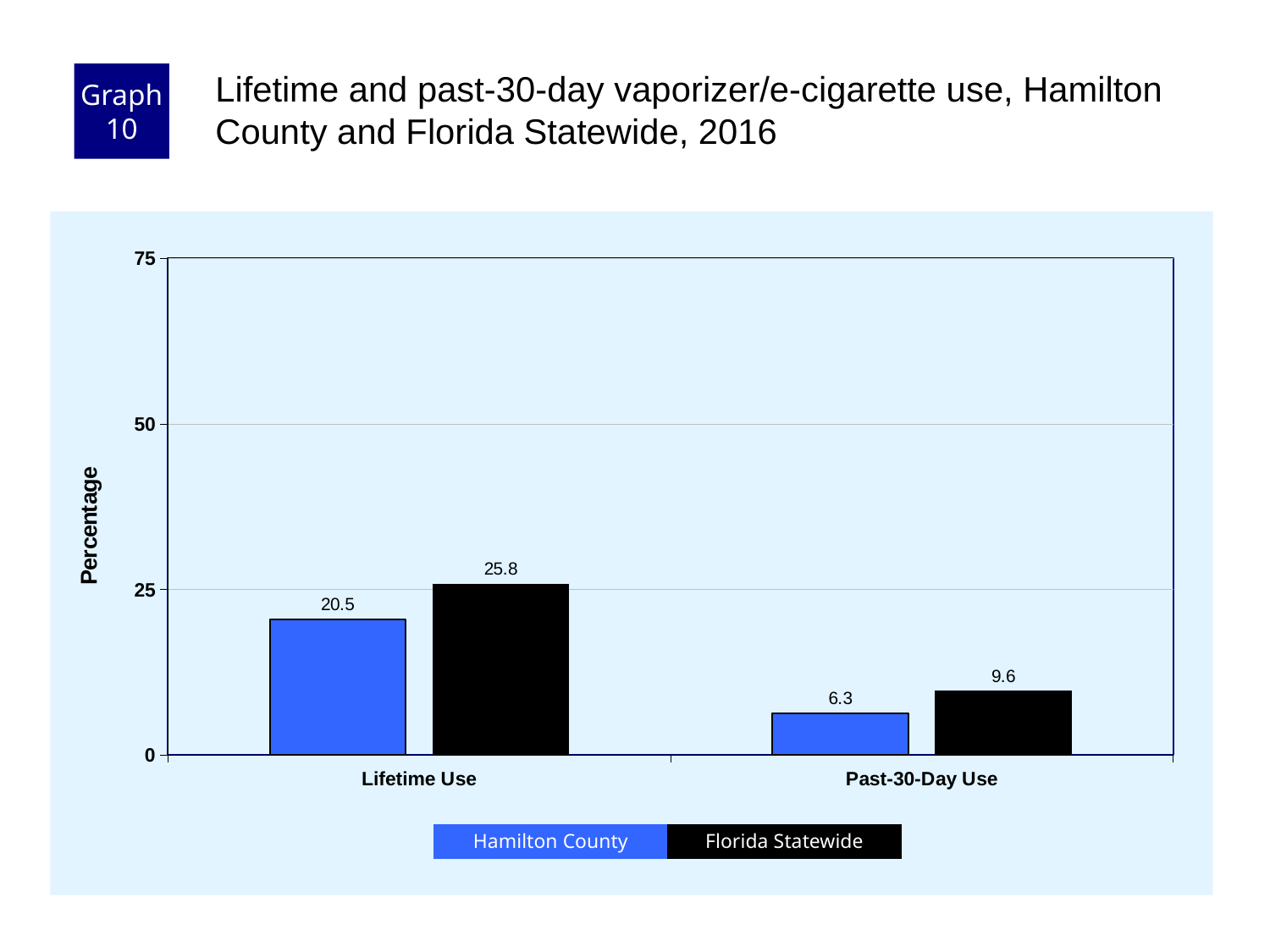
How many series does the legend list? 2 What is the difference between the Florida Statewide and Hamilton County values for Lifetime Use? 5.3 What is the Florida Statewide value for Past-30-Day Use? 9.6 What is the Florida Statewide value for Lifetime Use? 25.8 What is the difference between the Florida Statewide and Hamilton County values for Past-30-Day Use? 3.3 Which bar has the highest value on the chart? Florida Statewide, Lifetime Use Which bar has the lowest value on the chart? Hamilton County, Past-30-Day Use For Past-30-Day Use, which is larger: Hamilton County or Florida Statewide? Florida Statewide How many categories are shown on the x axis? 2 What is the Hamilton County value for Past-30-Day Use? 6.3 What type of chart is shown on the slide? Bar chart What is the Hamilton County value for Lifetime Use? 20.5